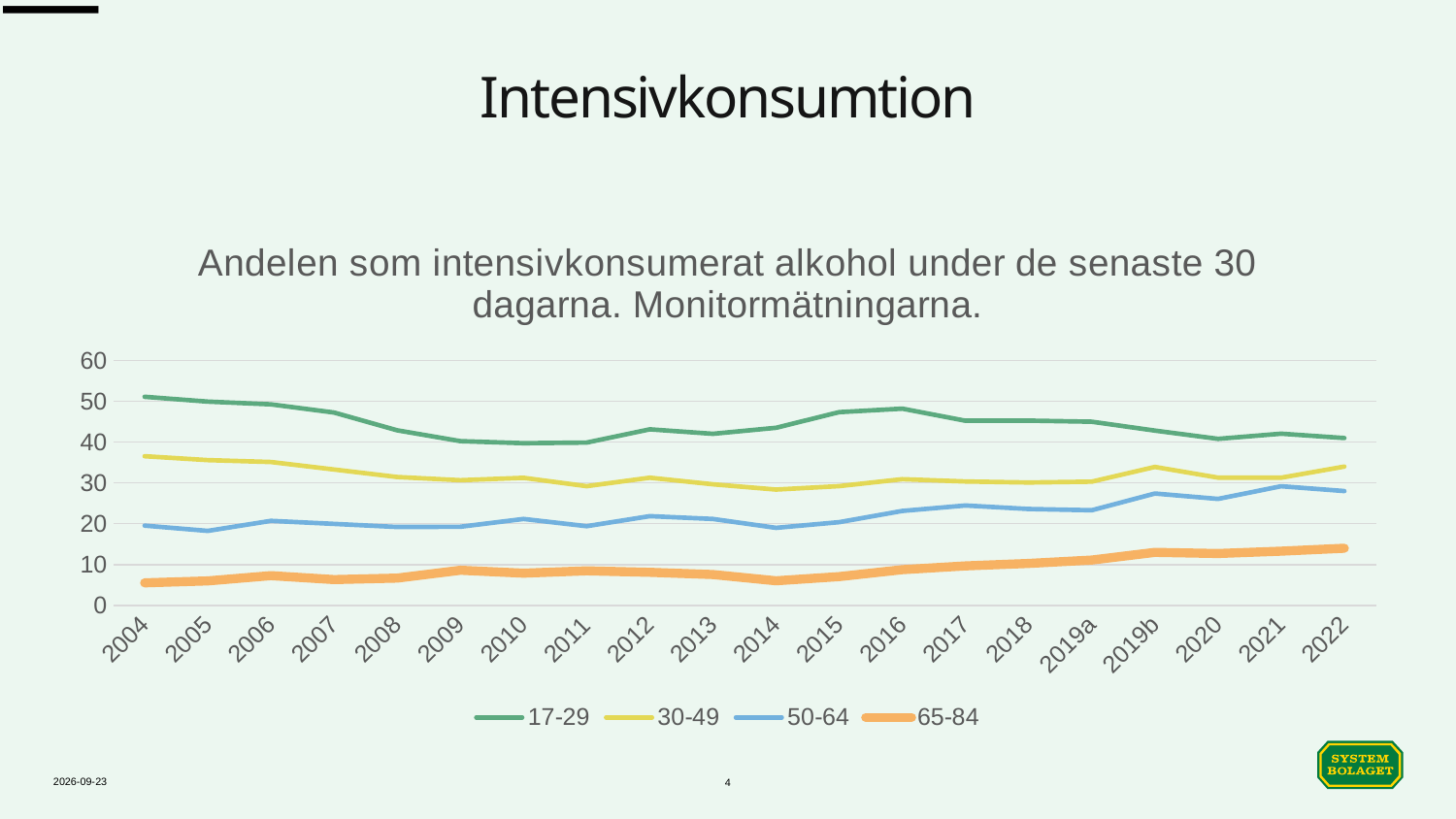
Is the value for 65-84 in 2004 greater or less than 10? less Is the value for 65-84 in 2022 greater or less than 10? greater What kind of chart is shown on the slide? line chart What is the title of the chart? Andelen som intensivkonsumerat alkohol under de senaste 30 dagarna. Monitormätningarna. Which age group has the highest value in 2022? 17-29 Which age group has the lowest value in 2004? 65-84 How many series does the legend list? 4 Which is larger in 2004, the value for 17-29 or the value for 30-49? 17-29 Does the value for 65-84 generally rise or fall from 2004 to 2022? rise Is the value for 30-49 in 2019b greater or less than 30? greater How many points are there along the x axis of the chart? 20